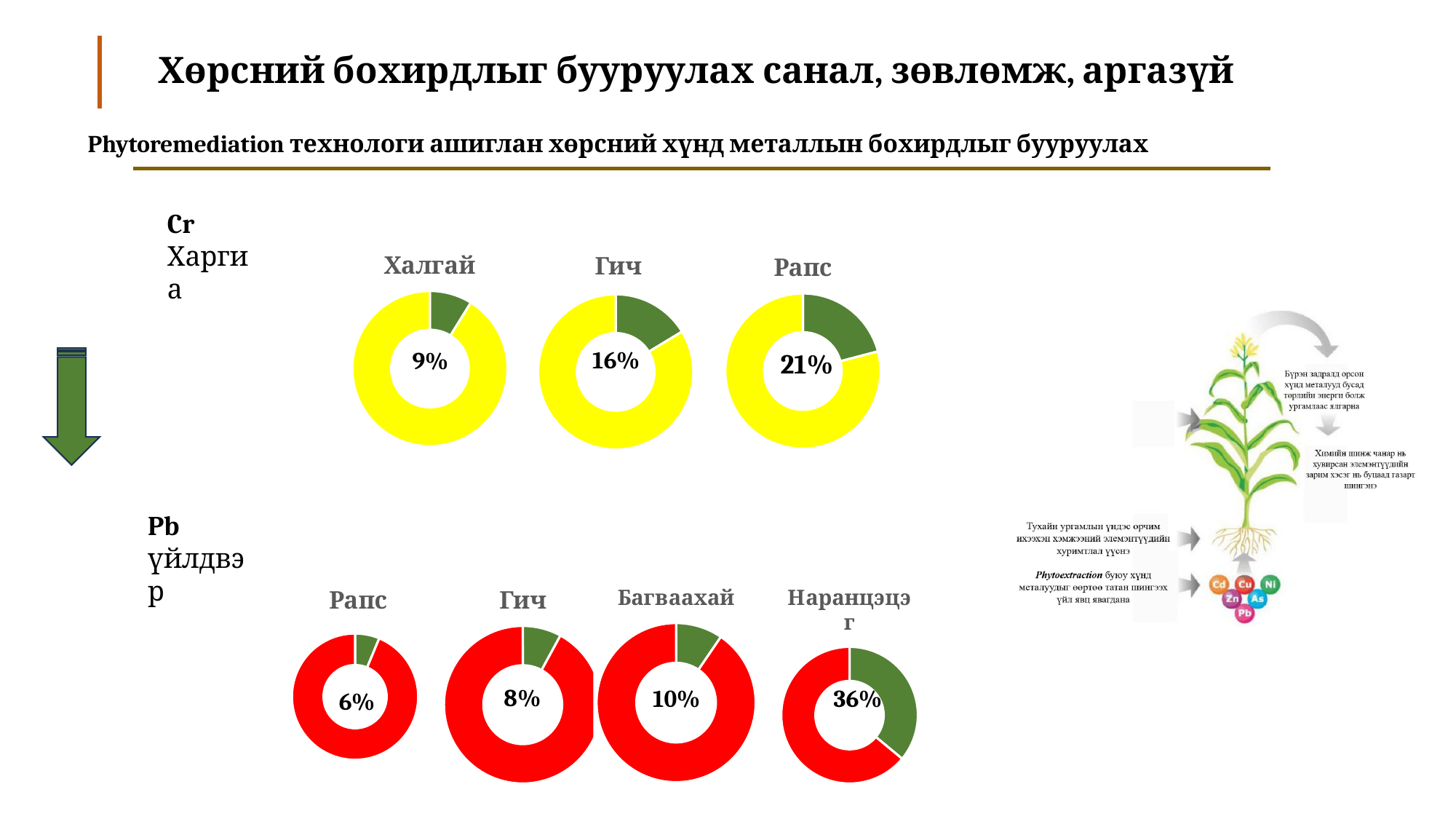
In the bottom row of donut charts (Pb үйлдвэр), which plant has the highest percentage? Наранцэцэг What is the difference between the Наранцэцэг and Гич percentages in the bottom row of donut charts (Pb үйлдвэр)? 28% In the top row of donut charts (Cr Харгиа), which plant has the highest percentage? Рапс Which is larger: the Гич percentage in the top row (Cr Харгиа) or the Гич percentage in the bottom row (Pb үйлдвэр)? Top row (Cr Харгиа), 16% In the top row of donut charts (Cr Харгиа), what percentage is shown in the Рапс chart? 21% In the top row of donut charts (Cr Харгиа), what percentage is shown in the Халгай chart? 9% In the bottom row of donut charts (Pb үйлдвэр), what percentage is shown in the Багваахай chart? 10% In the top row of donut charts (Cr Харгиа), what percentage is shown in the Гич chart? 16% How many donut charts are shown in the bottom row (Pb үйлдвэр)? 4 In the bottom row of donut charts (Pb үйлдвэр), what percentage is shown in the Наранцэцэг chart? 36% In the bottom row of donut charts (Pb үйлдвэр), which plant has the lowest percentage? Рапс What is the difference between the Рапс and Халгай percentages in the top row of donut charts (Cr Харгиа)? 12%